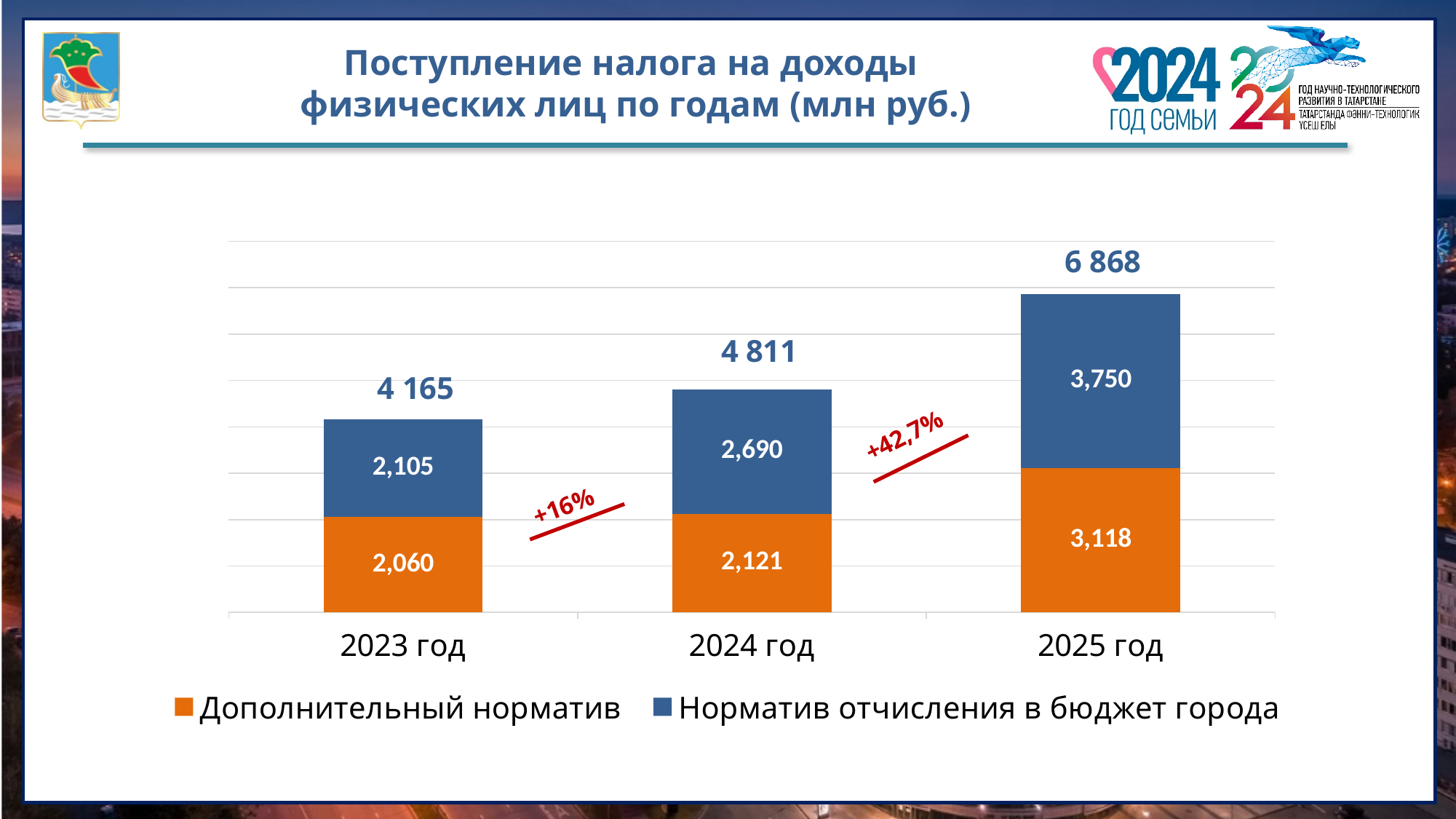
What type of chart is shown on the slide? Stacked bar chart What percentage growth is shown between 2024 год and 2025 год? +42,7% What is the value of "Норматив отчисления в бюджет города" for 2024 год? 2,690 Which is larger in 2024 год: "Дополнительный норматив" or "Норматив отчисления в бюджет города"? Норматив отчисления в бюджет города What is the total of the stacked bar for 2025 год? 6 868 What is the value of "Дополнительный норматив" for 2023 год? 2,060 What is the difference between the "Норматив отчисления в бюджет города" values for 2025 год and 2024 год? 1,060 Which year has the highest total? 2025 год What is the value of "Дополнительный норматив" for 2025 год? 3,118 What is the total of the stacked bar for 2023 год? 4 165 Which year has the lowest value for "Норматив отчисления в бюджет города"? 2023 год How many series does the legend list? 2